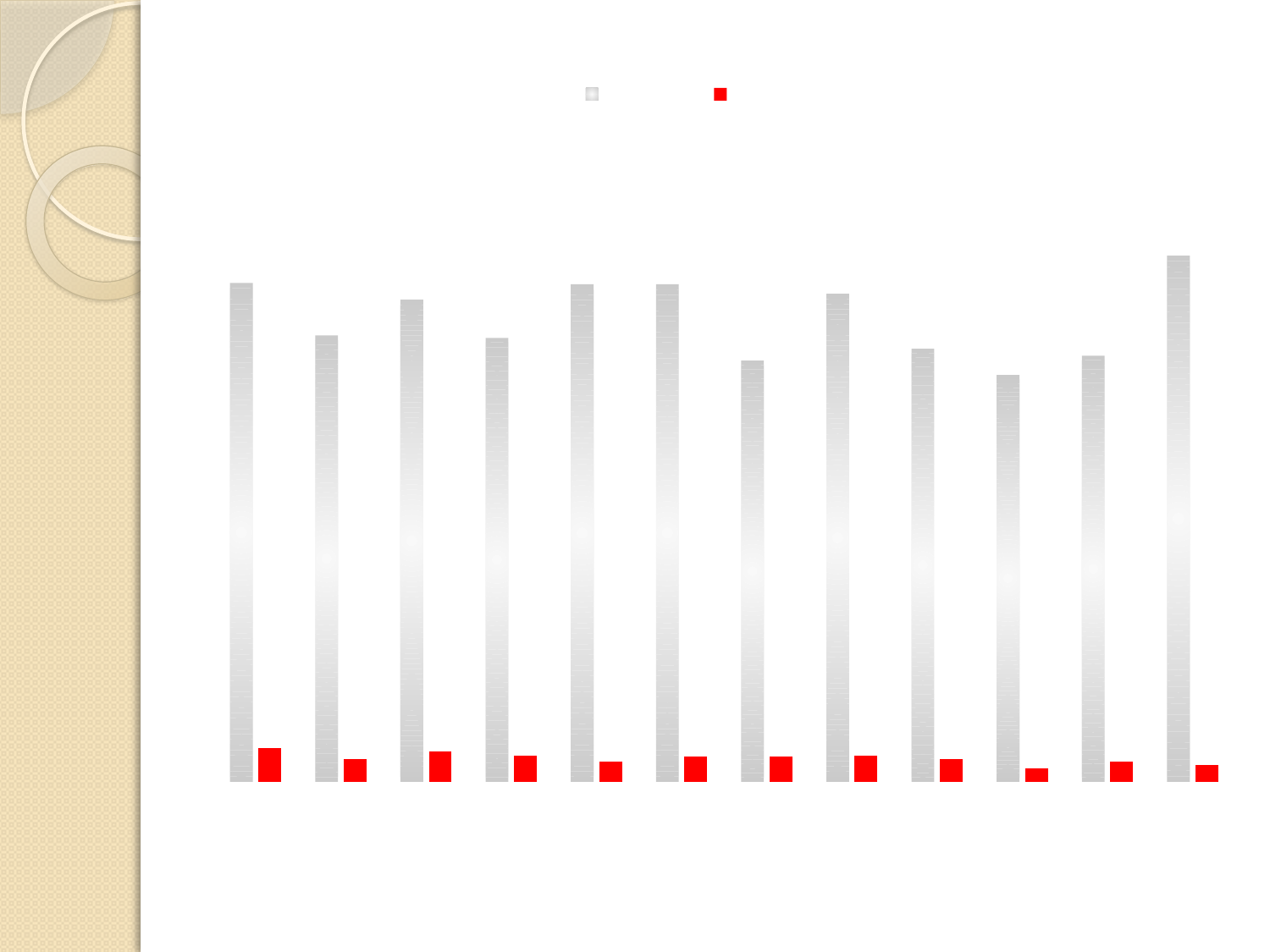
In each group, which series has the taller bar, the grey one or the red one? grey What two colours are used for the bars in the chart? grey and red Is the grey bar in the 12th group taller or shorter than the grey bar in the 1st group? taller How many groups of bars are plotted in the chart? 12 What kind of chart is shown on the slide? bar chart Which group, counting from the left, has the tallest grey bar? the 12th (last) group Is the grey bar in the 10th group taller or shorter than the grey bar in the 9th group? shorter How many series does the legend list? 2